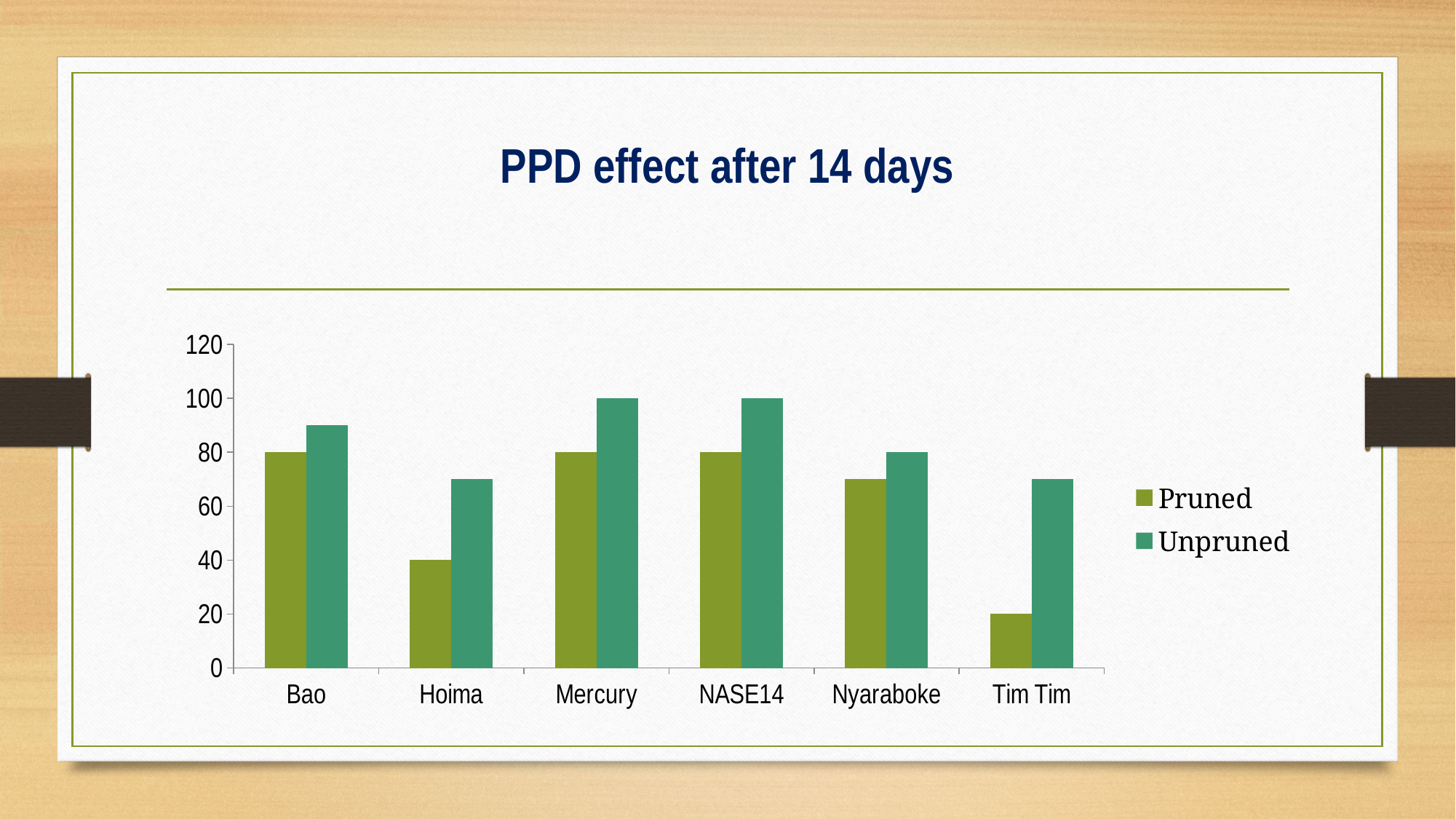
What is the title of the chart? PPD effect after 14 days What is the Pruned value for Bao? 80 What is the Pruned value for Hoima? 40 How many varieties are shown on the x axis? 6 What is the Unpruned value for Mercury? 100 What is the Pruned value for Tim Tim? 20 How many series does the legend list? 2 What type of chart is shown on the slide? bar chart What is the difference between the Unpruned and Pruned values for NASE14? 20 Which variety has the lowest Pruned value? Tim Tim Is the Unpruned value for Bao greater or less than 80? greater Which is larger, the Pruned value for Hoima or the Pruned value for Tim Tim? Hoima